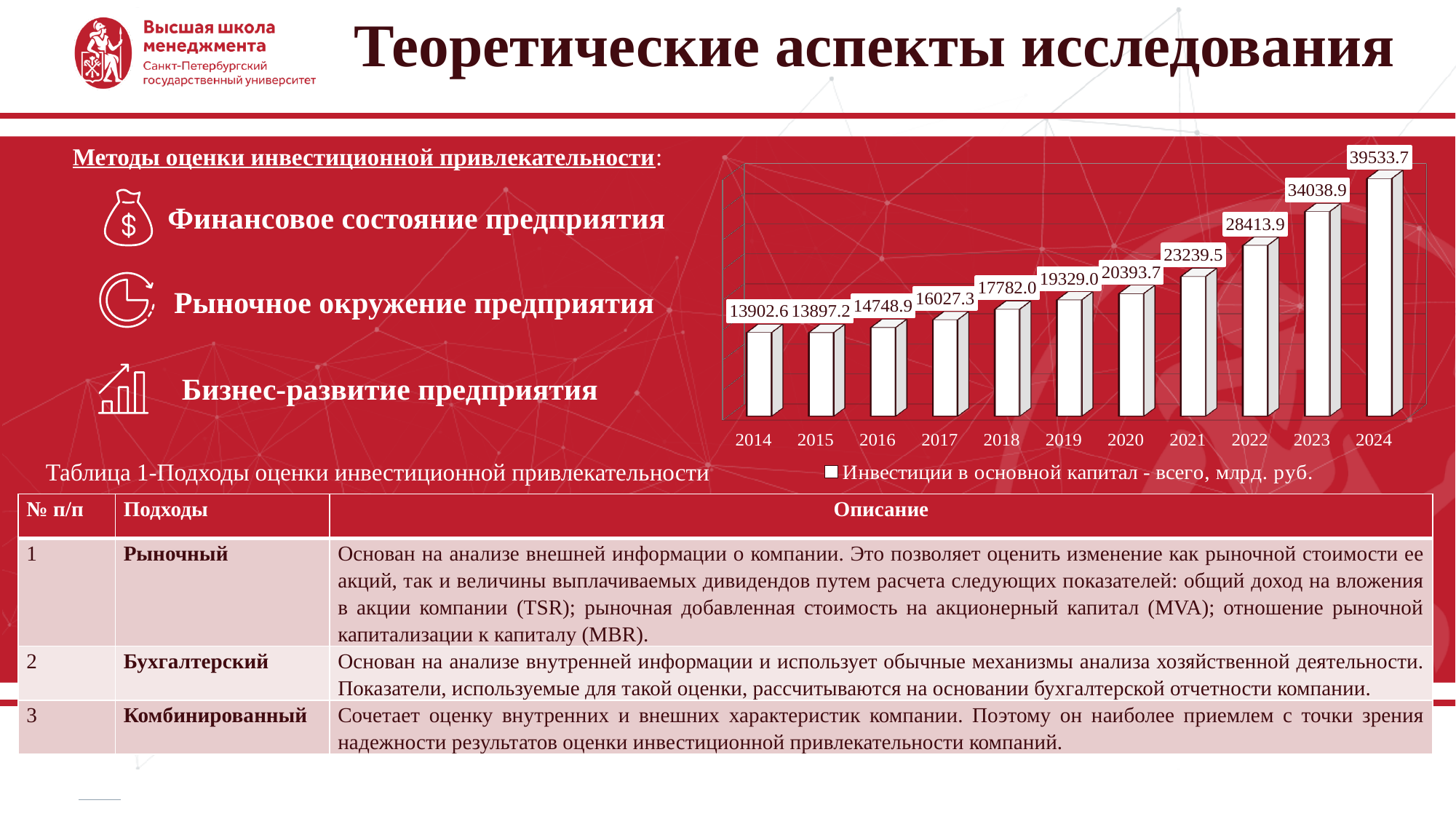
What is the value for 2024 on the chart? 39533.7 What is the difference between the values for 2024 and 2023? 5494.8 How many years are shown on the x axis of the chart? 11 Which is larger, the value for 2020 or the value for 2021? 2021 What is the legend entry of the chart? Инвестиции в основной капитал - всего, млрд. руб. What is the difference between the values for 2022 and 2021? 5174.4 What is the value for 2018 on the chart? 17782.0 What kind of chart is shown on the slide? bar chart Which year has the lowest value on the chart? 2015 Which year has the highest value on the chart? 2024 How many series does the chart legend list? 1 What is the value for 2014 on the chart? 13902.6